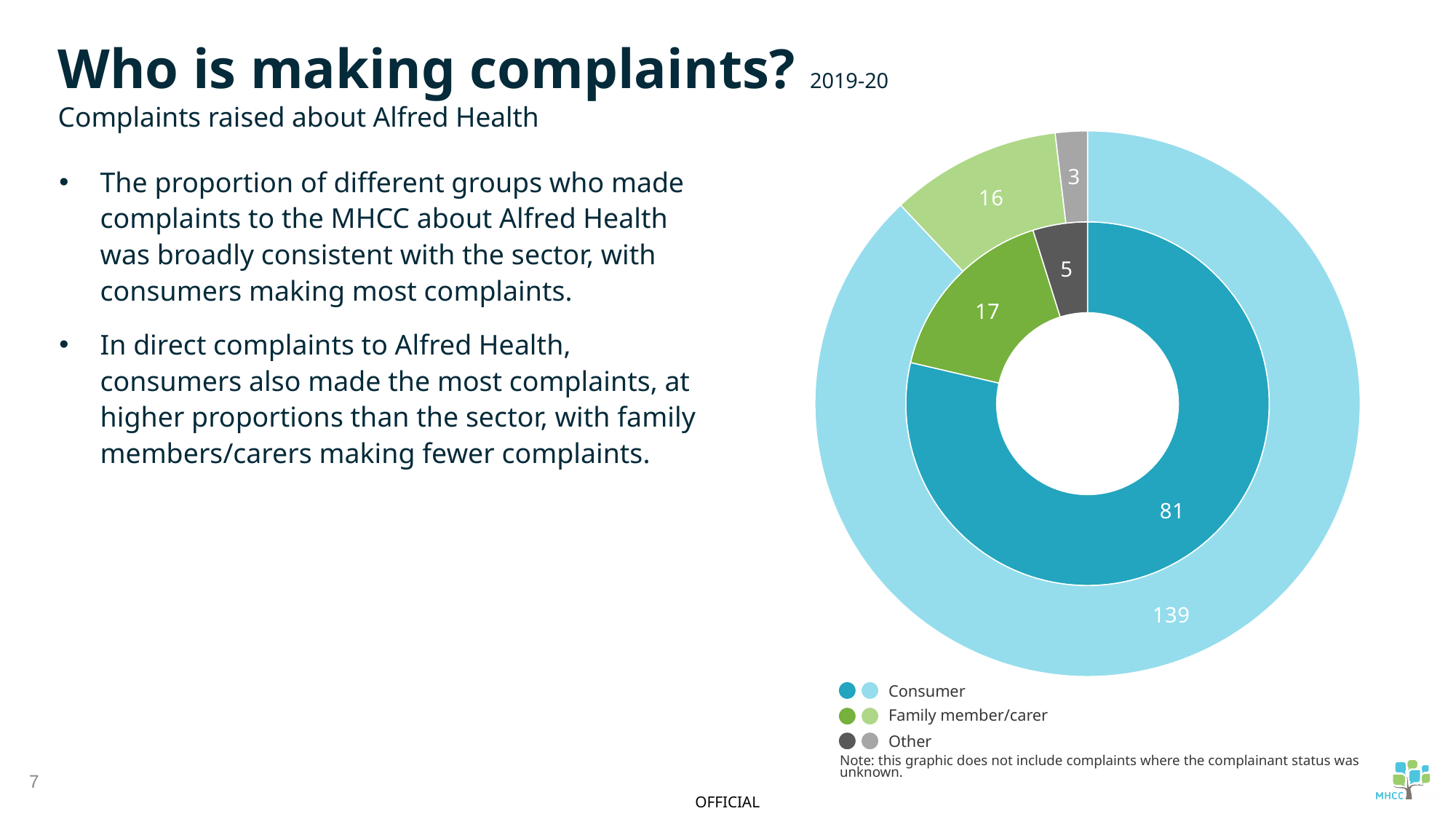
What is the value for Family member/carer in the inner ring of the doughnut chart? 17 Which category has the smallest value in the outer ring of the doughnut chart? Other In the outer ring, what is the difference between the Consumer value and the Family member/carer value? 123 What is the value for Consumer in the outer ring of the doughnut chart? 139 What is the value for Other in the outer ring of the doughnut chart? 3 Which category has the largest value in the inner ring of the doughnut chart? Consumer What kind of chart is shown on the slide? Doughnut chart How many categories does the legend of the doughnut chart list? 3 What is the total of the three values in the inner ring of the doughnut chart? 103 What are the three legend entries of the doughnut chart? Consumer, Family member/carer, Other What is the value for Consumer in the inner ring of the doughnut chart? 81 Which is larger: the Family member/carer value in the inner ring or in the outer ring? Inner ring